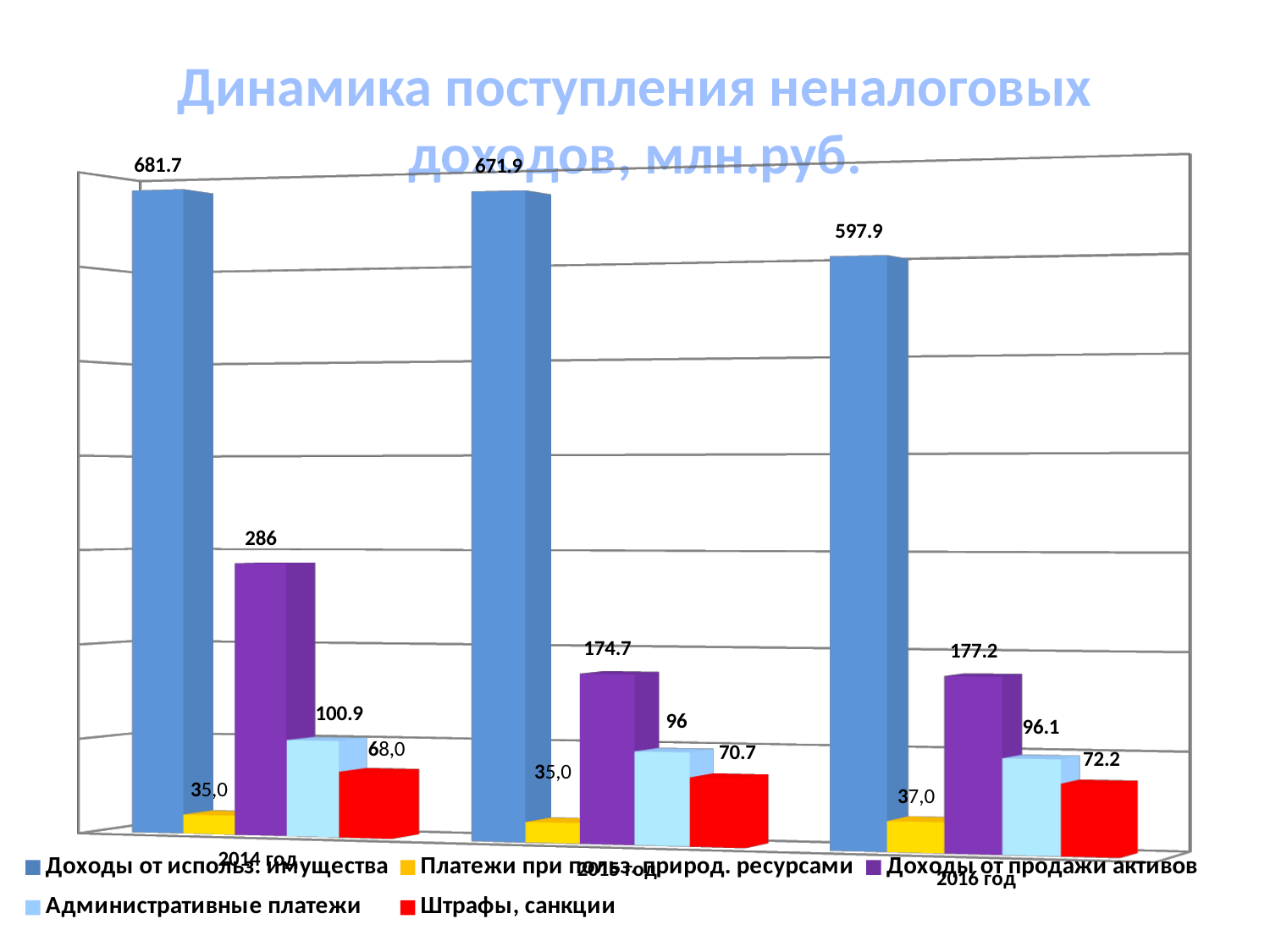
What is the difference between Доходы от использ. имущества in 2014 год and in 2016 год? 83.8 Does Доходы от использ. имущества rise or fall from 2014 год to 2016 год? Fall What is the value for Доходы от использ. имущества in 2014 год? 681.7 In which year is Доходы от использ. имущества the lowest? 2016 год How many series does the legend list? 5 How many years are shown on the x axis? 3 What is the value for Доходы от продажи активов in 2015 год? 174.7 What is the value for Административные платежи in 2014 год? 100.9 In which year is Доходы от продажи активов the highest? 2014 год Which is larger: Административные платежи in 2015 год or Штрафы, санкции in 2015 год? Административные платежи What kind of chart is shown on the slide? Bar chart What is the value for Штрафы, санкции in 2016 год? 72.2